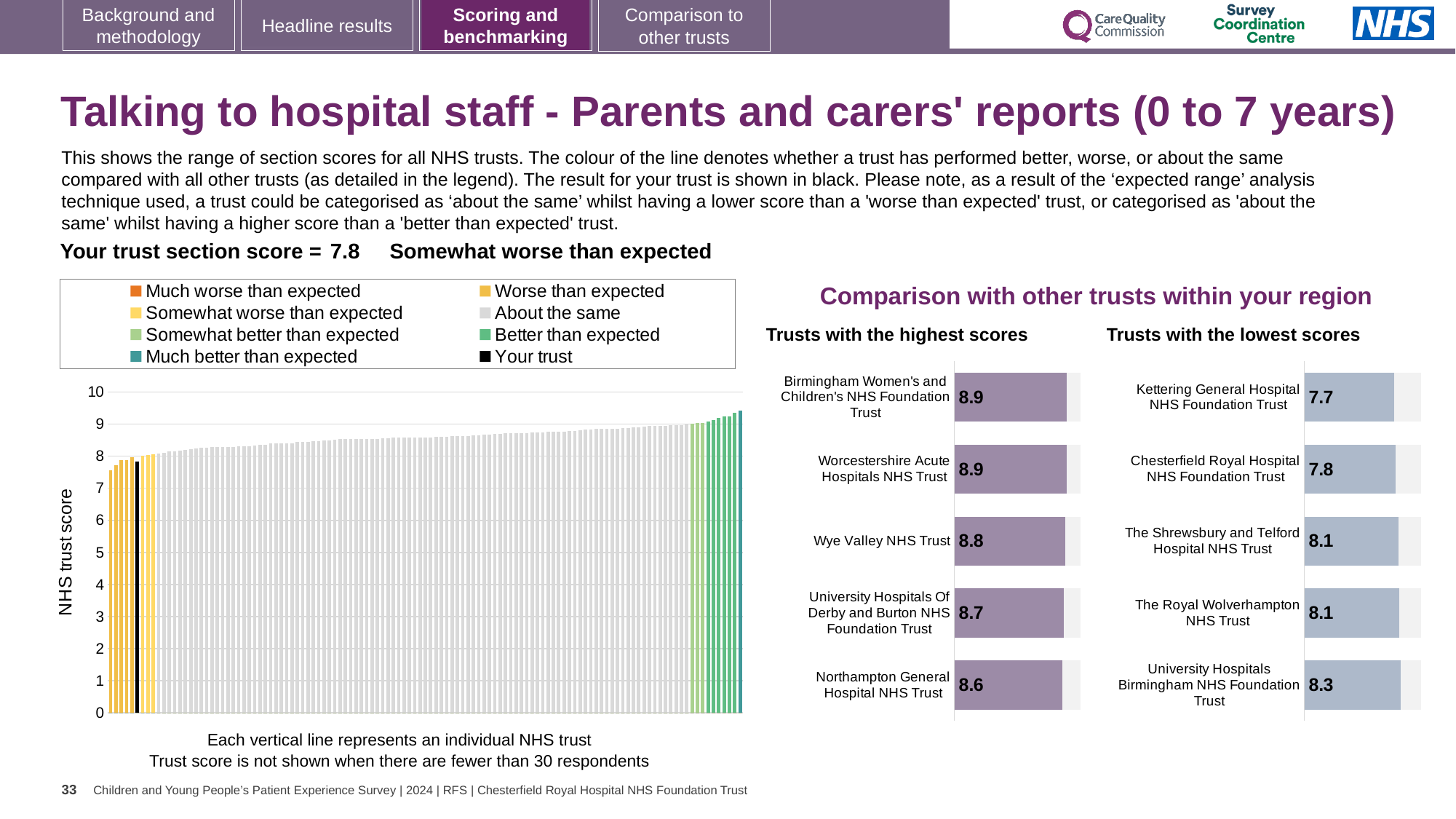
What kind of chart is the NHS trust score chart on the left of the slide? Bar chart In the 'Trusts with the highest scores' chart, which trust has the lowest score? Northampton General Hospital NHS Trust In the 'Trusts with the lowest scores' chart, what is the difference between the scores of University Hospitals Birmingham NHS Foundation Trust and Kettering General Hospital NHS Foundation Trust? 0.6 How many entries does the legend of the NHS trust score chart on the left list? 8 In the 'Trusts with the highest scores' chart, what is the difference between the scores of Birmingham Women's and Children's NHS Foundation Trust and Northampton General Hospital NHS Trust? 0.3 How many trusts are shown in the 'Trusts with the highest scores' chart? 5 In the 'Trusts with the highest scores' chart, which has the higher score: Wye Valley NHS Trust or University Hospitals Of Derby and Burton NHS Foundation Trust? Wye Valley NHS Trust In the 'Trusts with the lowest scores' chart, what is the score for Kettering General Hospital NHS Foundation Trust? 7.7 In the 'Trusts with the lowest scores' chart, which trust has the highest score? University Hospitals Birmingham NHS Foundation Trust In the 'Trusts with the highest scores' chart, what is the score for Wye Valley NHS Trust? 8.8 What is the section score for your trust shown on the slide? 7.8 In the NHS trust score chart on the left, do the values rise or fall from left to right? Rise